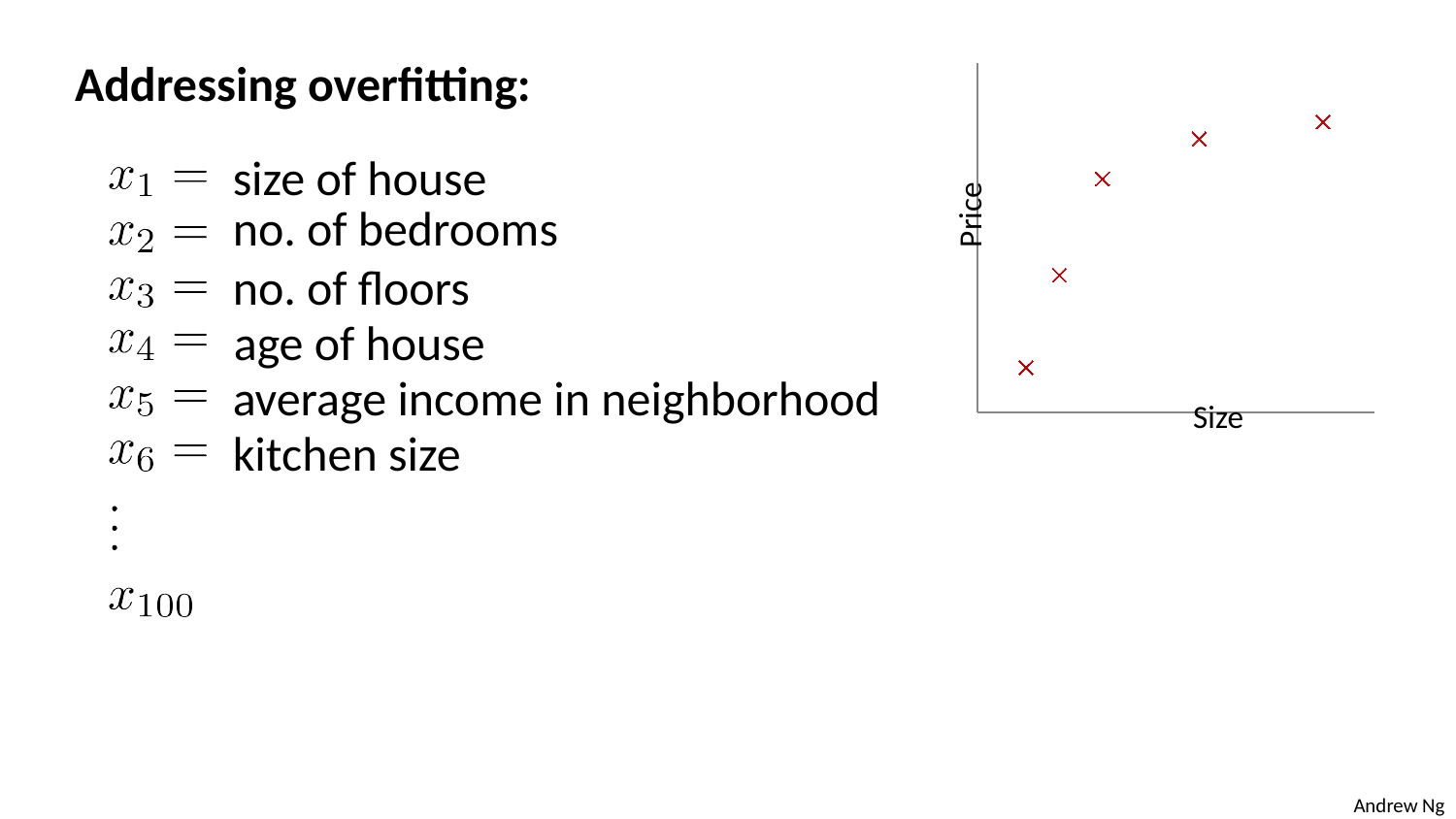
What is the label on the horizontal axis of the chart? Size What is the label on the vertical axis of the chart? Price Do the plotted values rise or fall as you move along the x axis from left to right? rise What kind of chart is shown on the slide? scatter plot How many data points are plotted on the chart? 5